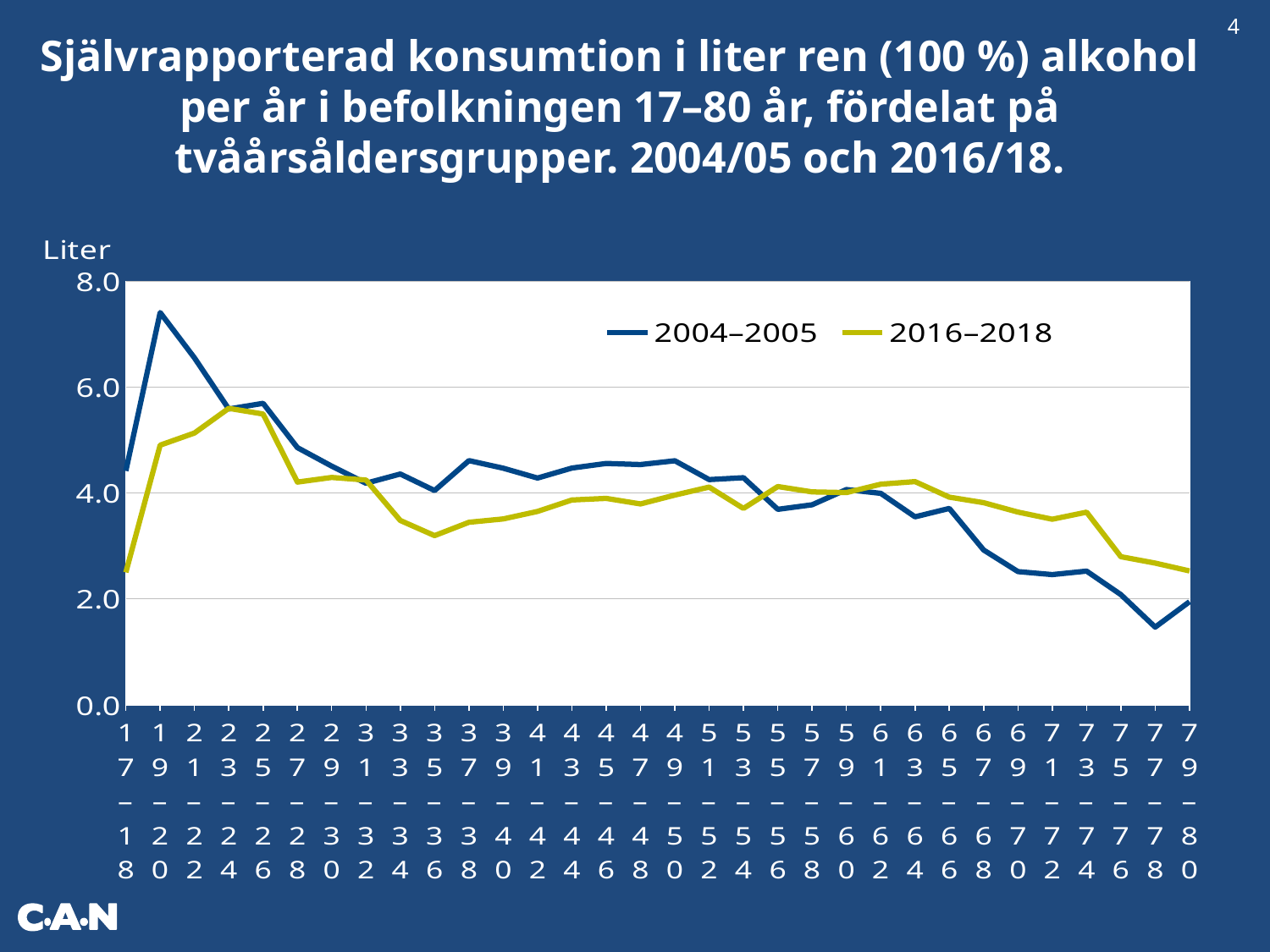
How many two-year age groups are plotted along the x axis? 32 Is the 2016–2018 value for age group 17–18 greater or less than 4.0? less Is the 2004–2005 value for age group 19–20 greater or less than 6.0? greater Is the 2004–2005 value for age group 77–78 greater or less than 2.0? less What is the label on the vertical axis? Liter For which age group is the 2004–2005 series lowest? 77–78 What kind of chart is shown on the slide? Line chart For age group 75–76, which series has the higher value, 2004–2005 or 2016–2018? 2016–2018 How many series does the legend list? 2 Which two series are listed in the legend? 2004–2005 and 2016–2018 For age group 19–20, which series has the higher value, 2004–2005 or 2016–2018? 2004–2005 For which age group is the 2004–2005 series highest? 19–20